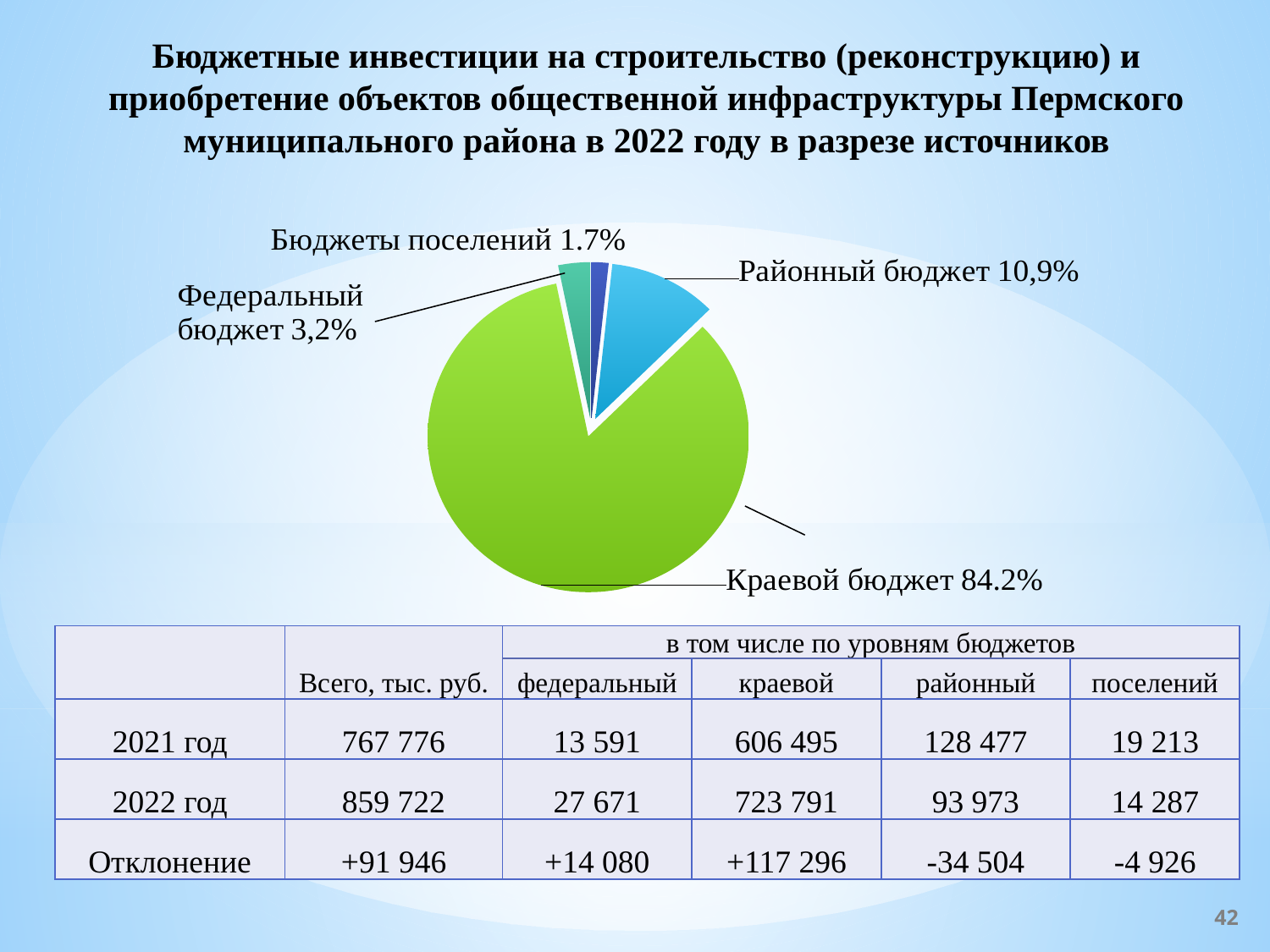
What kind of chart is shown on the slide? Pie chart Which is larger in the pie chart: Федеральный бюджет or Бюджеты поселений? Федеральный бюджет Which slice of the pie chart is the largest? Краевой бюджет What share of the pie chart does Федеральный бюджет hold? 3,2% How many slices does the pie chart have? 4 What share of the pie chart does Районный бюджет hold? 10,9% What share of the pie chart does Краевой бюджет hold? 84.2% Which is larger in the pie chart: Районный бюджет or Федеральный бюджет? Районный бюджет What is the difference in percentage points between the Районный бюджет and Федеральный бюджет slices? 7,7 What share of the pie chart does Бюджеты поселений hold? 1.7% What colour is the Краевой бюджет slice in the pie chart? Green Which slice of the pie chart is the smallest? Бюджеты поселений